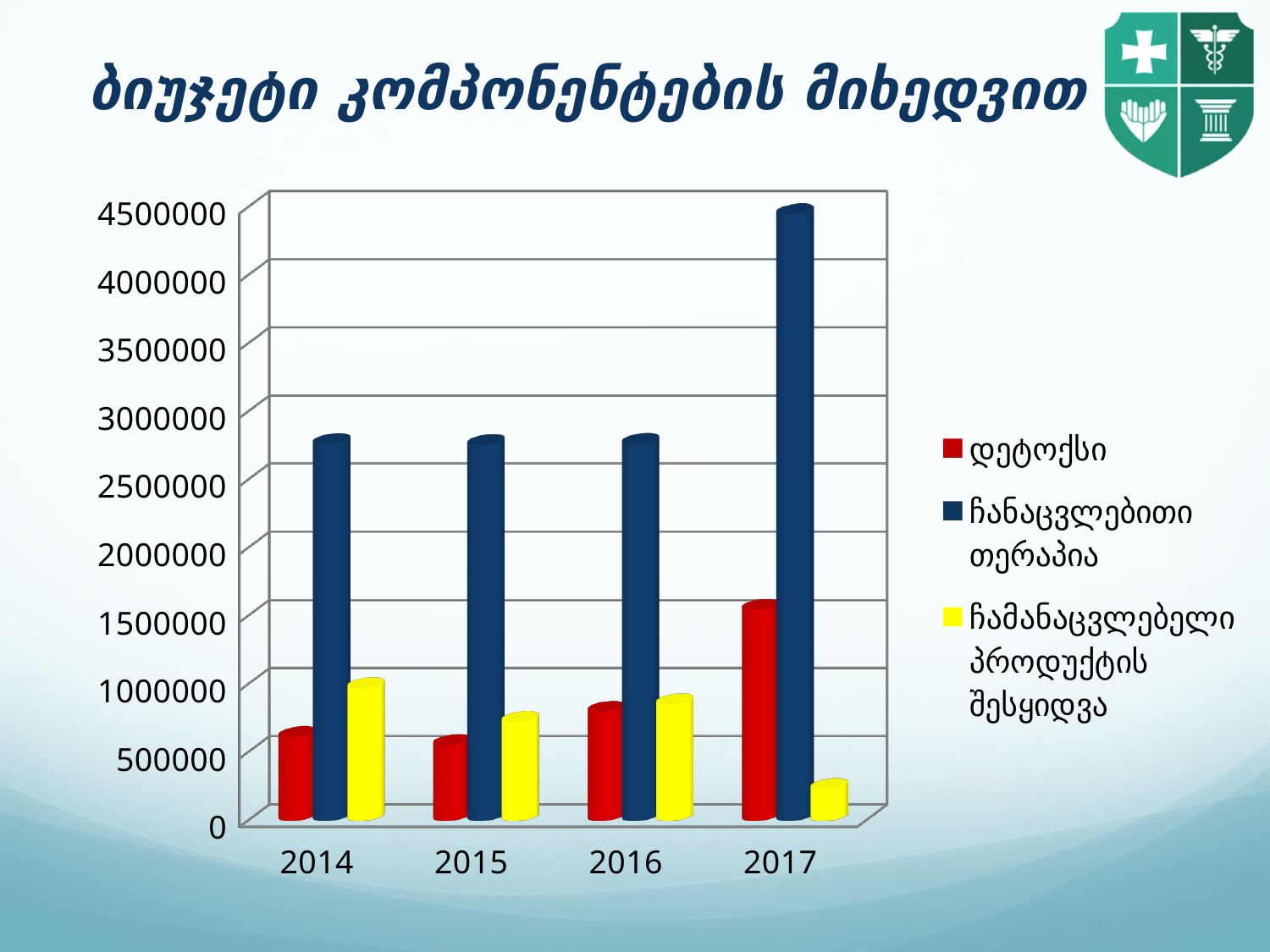
What kind of chart is shown on the slide? bar chart Is the value for დეტოქსი in 2017 greater or less than 1000000? greater How many series does the legend list? 3 Is the value for ჩამანაცვლებელი პროდუქტის შესყიდვა in 2017 greater or less than 500000? less In which year is the value for ჩამანაცვლებელი პროდუქტის შესყიდვა lowest? 2017 Which series is shown in yellow in the legend? ჩამანაცვლებელი პროდუქტის შესყიდვა In which year is the value for დეტოქსი highest? 2017 In 2017, which is larger: the value for დეტოქსი or the value for ჩამანაცვლებელი პროდუქტის შესყიდვა? დეტოქსი In which year is the value for ჩანაცვლებითი თერაპია highest? 2017 Is the value for ჩანაცვლებითი თერაპია in 2014 greater or less than 3000000? less How many years are shown on the x axis of the chart? 4